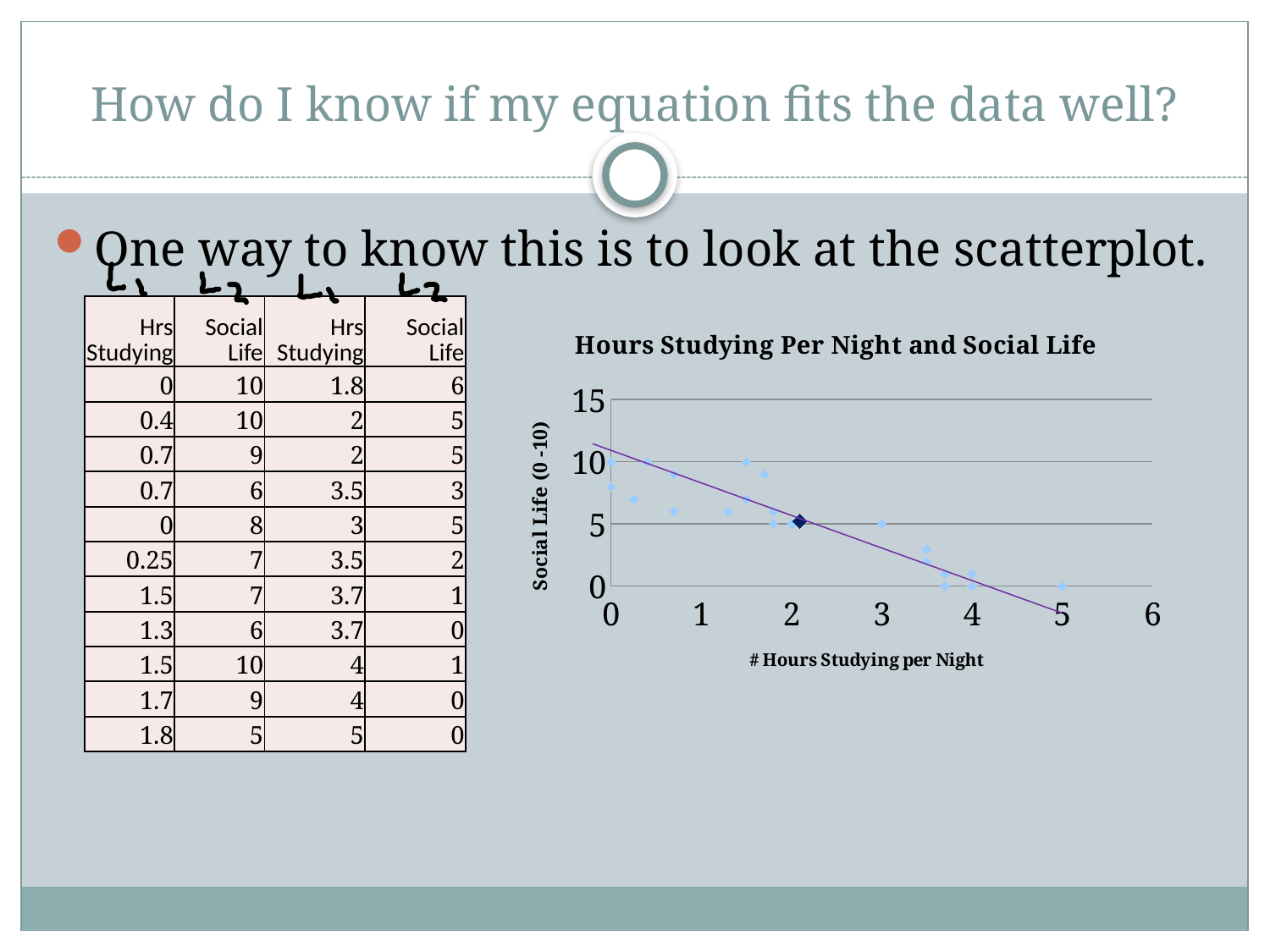
As the number of hours studying per night increases, do the social life values rise or fall? fall Is the social life value for the point at 5 hours studying greater or less than 5? less What is the largest number of hours studying per night among the plotted points? 5 What is the lowest social life value plotted on the chart? 0 What is the label of the vertical axis of the chart? Social Life (0 -10) What is the title of the chart? Hours Studying Per Night and Social Life What is the highest social life value plotted on the chart? 10 What kind of chart is shown on the slide? scatter plot What is the highest value shown on the vertical axis of the chart? 15 What is the highest value shown on the horizontal axis of the chart? 6 Is the social life value for the point at 0 hours studying greater or less than 5? greater How many data points are listed in the table on the slide? 22